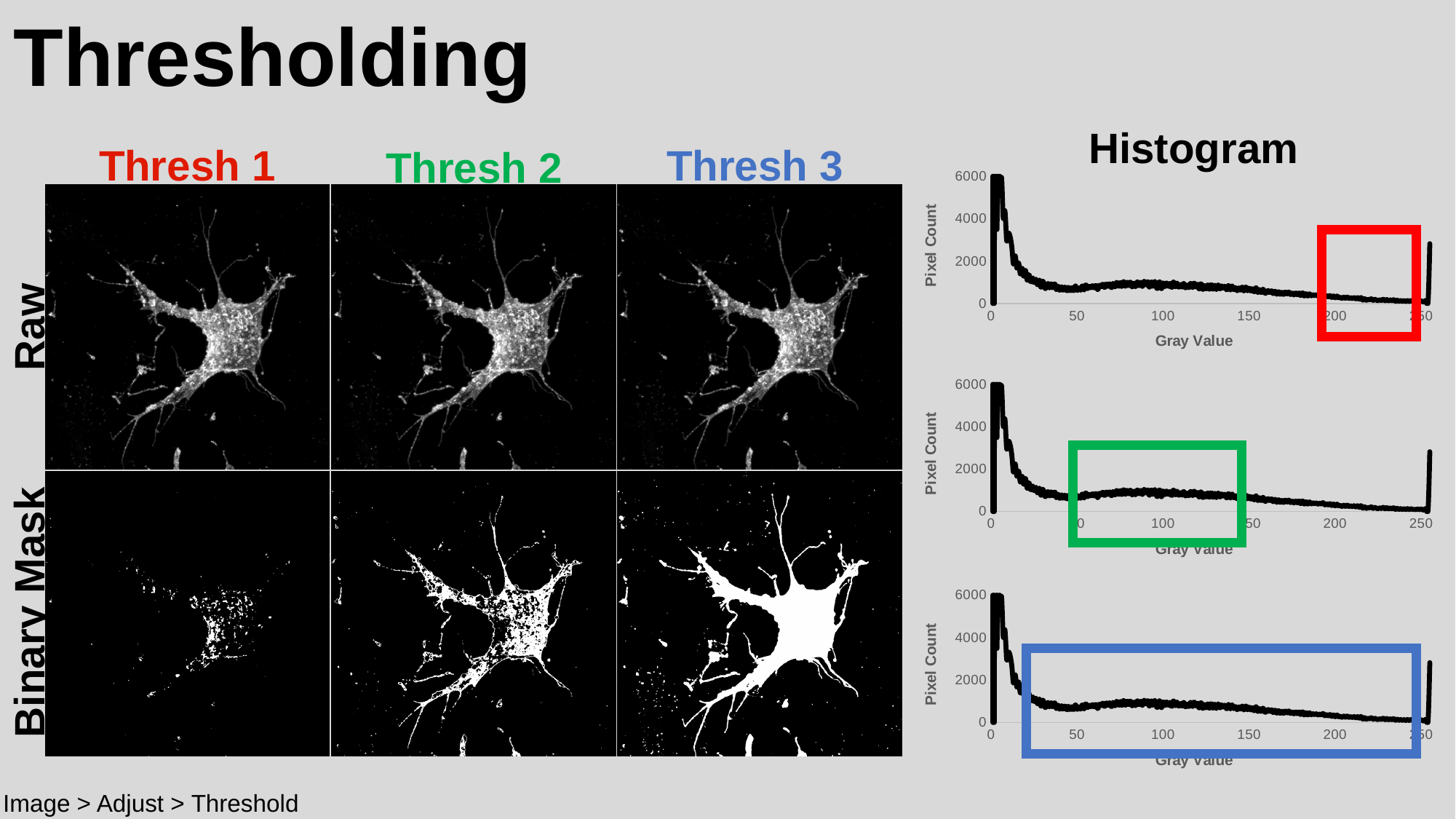
In the top histogram, is the pixel count at gray value 100 greater or less than 2000? less How many histogram charts are shown on the slide? 3 In the middle histogram, is the peak pixel count greater or less than 4000? greater In the top histogram, does the pixel count rise or fall as gray value goes from 100 to 200? fall What is the highest tick value shown on the Pixel Count axis of the histograms? 6000 What kind of chart is used for the histograms on the right of the slide? line chart What colour is the box drawn on the top histogram? red In the histograms, is the peak pixel count at the low end or the high end of the Gray Value axis? low end What is the highest tick value shown on the Gray Value axis of the histograms? 250 What is the label of the x axis on the histogram charts? Gray Value In the bottom histogram, is the pixel count at gray value 200 greater or less than 1000? less